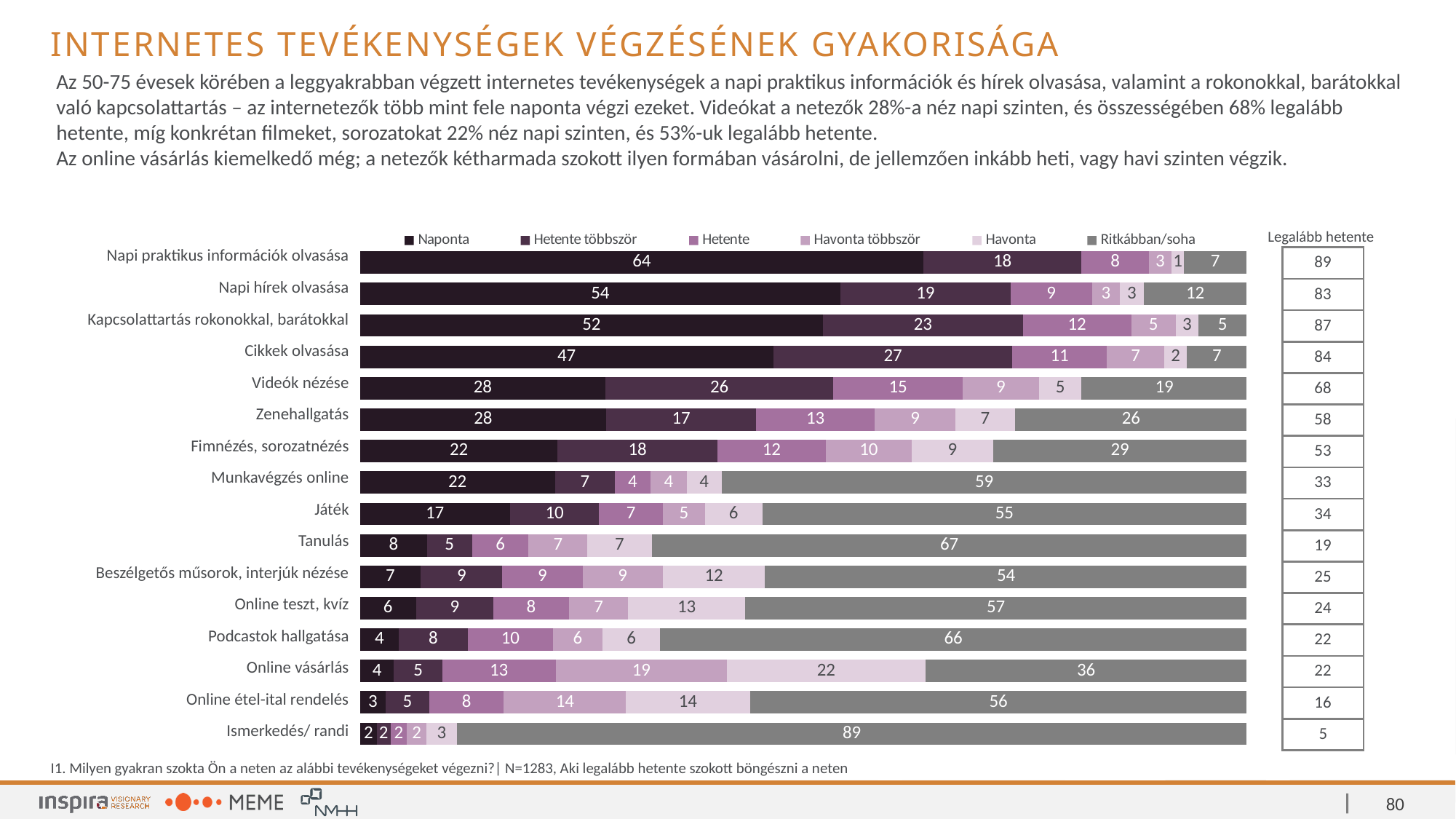
What is the total of the stacked bar for Munkavégzés online? 100 What is the first entry in the chart's legend? Naponta Which category has the lowest value in the Naponta series? Ismerkedés/ randi What is the difference between the Naponta values for Napi praktikus információk olvasása and Napi hírek olvasása? 10 How many categories (activities) are shown in the chart? 16 What is the value of the Ritkábban/soha series for Ismerkedés/ randi? 89 Which category has the highest value in the Naponta series? Napi praktikus információk olvasása What is the value of the Naponta series for Videók nézése? 28 What kind of chart is shown on the slide? Stacked bar chart How many series does the legend list? 6 What is the Legalább hetente value shown for Zenehallgatás? 58 Which has the larger Havonta value: Online vásárlás or Online étel-ital rendelés? Online vásárlás